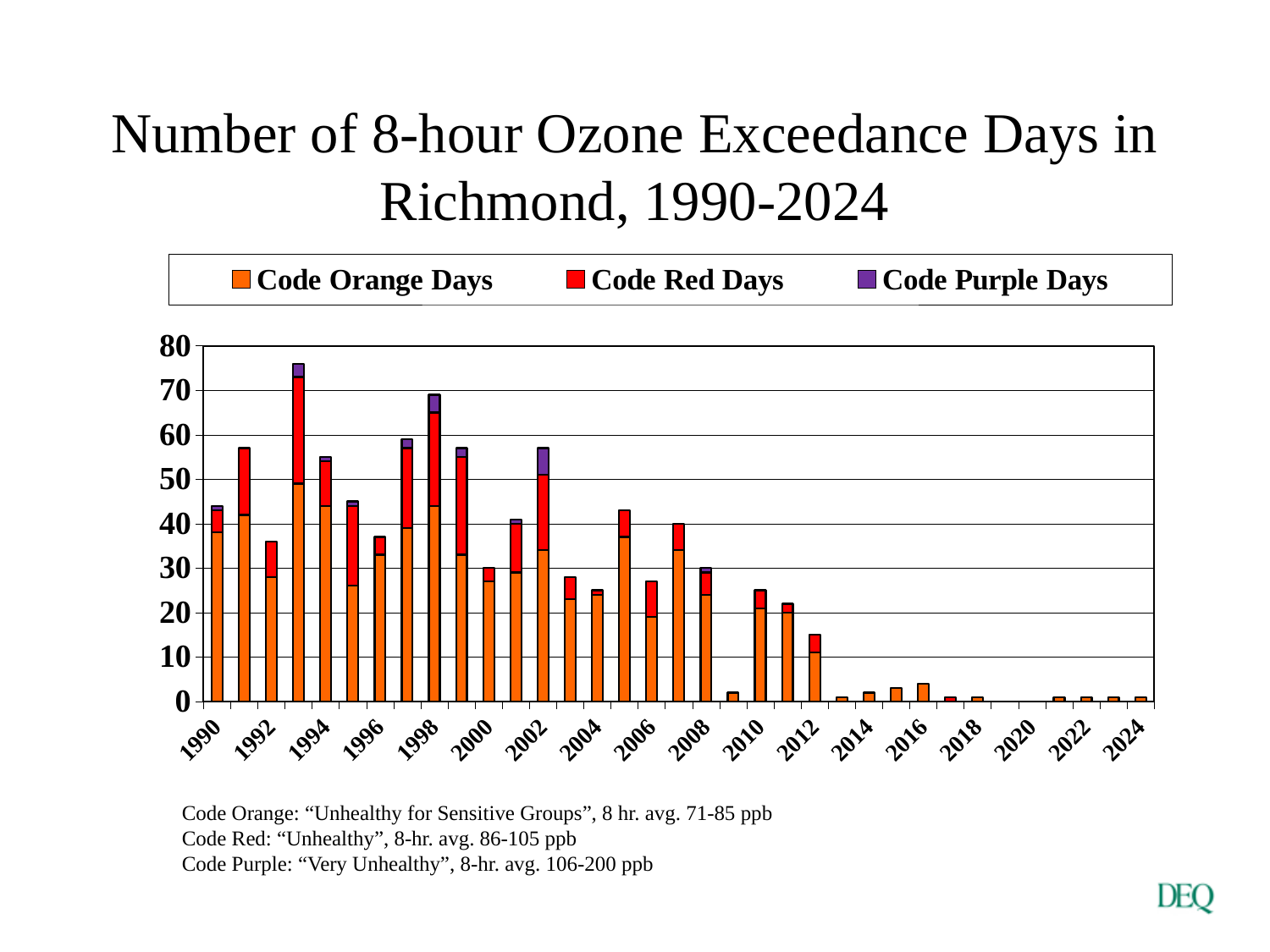
Is the total value for 2002 greater or less than 50? greater Which year has the highest total number of exceedance days? 1993 Which year has the larger total, 1992 or 1993? 1993 Is the total value for 2009 greater or less than 10? less How many series does the legend list? 3 Which year has the larger total, 1995 or 1996? 1995 Which series is shown in purple in the legend? Code Purple Days Is the total value for 1993 greater or less than 70? greater Overall, do the total exceedance days rise or fall from 1990 to 2024? fall What kind of chart is shown on the slide? bar chart